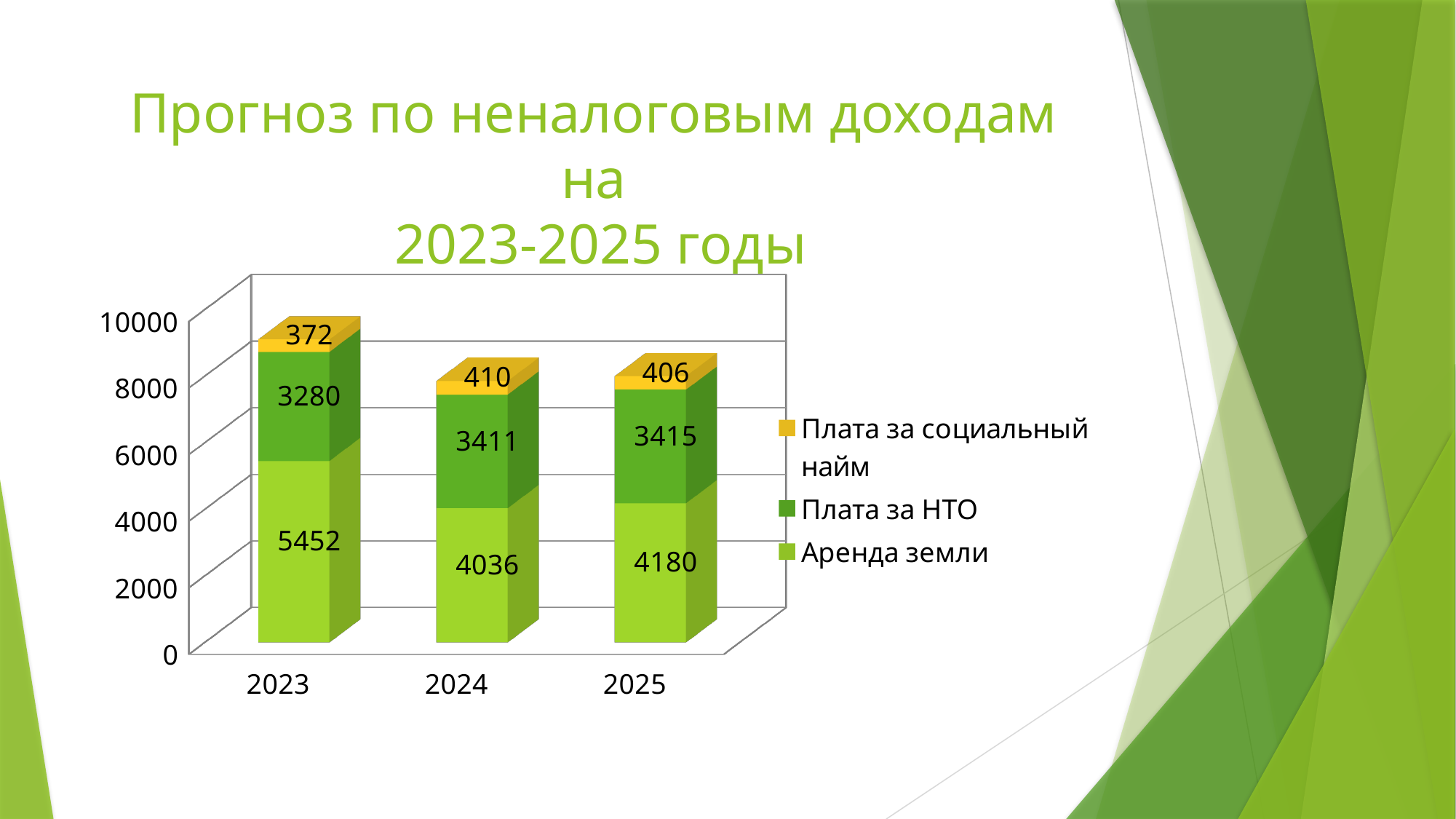
What is the value for Аренда земли in 2023? 5452 What is the value for Плата за социальный найм in 2025? 406 Which is larger: Плата за НТО in 2023 or in 2025? 2025 What is the total of the stacked bar for 2023? 9104 How many years are shown on the x axis? 3 What is the total of the stacked bar for 2025? 8001 In which year is Аренда земли highest? 2023 What is the difference between Аренда земли in 2023 and in 2024? 1416 How many series does the legend list? 3 What is the value for Плата за НТО in 2024? 3411 In which year is Плата за социальный найм lowest? 2023 What kind of chart is shown on the slide? Stacked bar chart